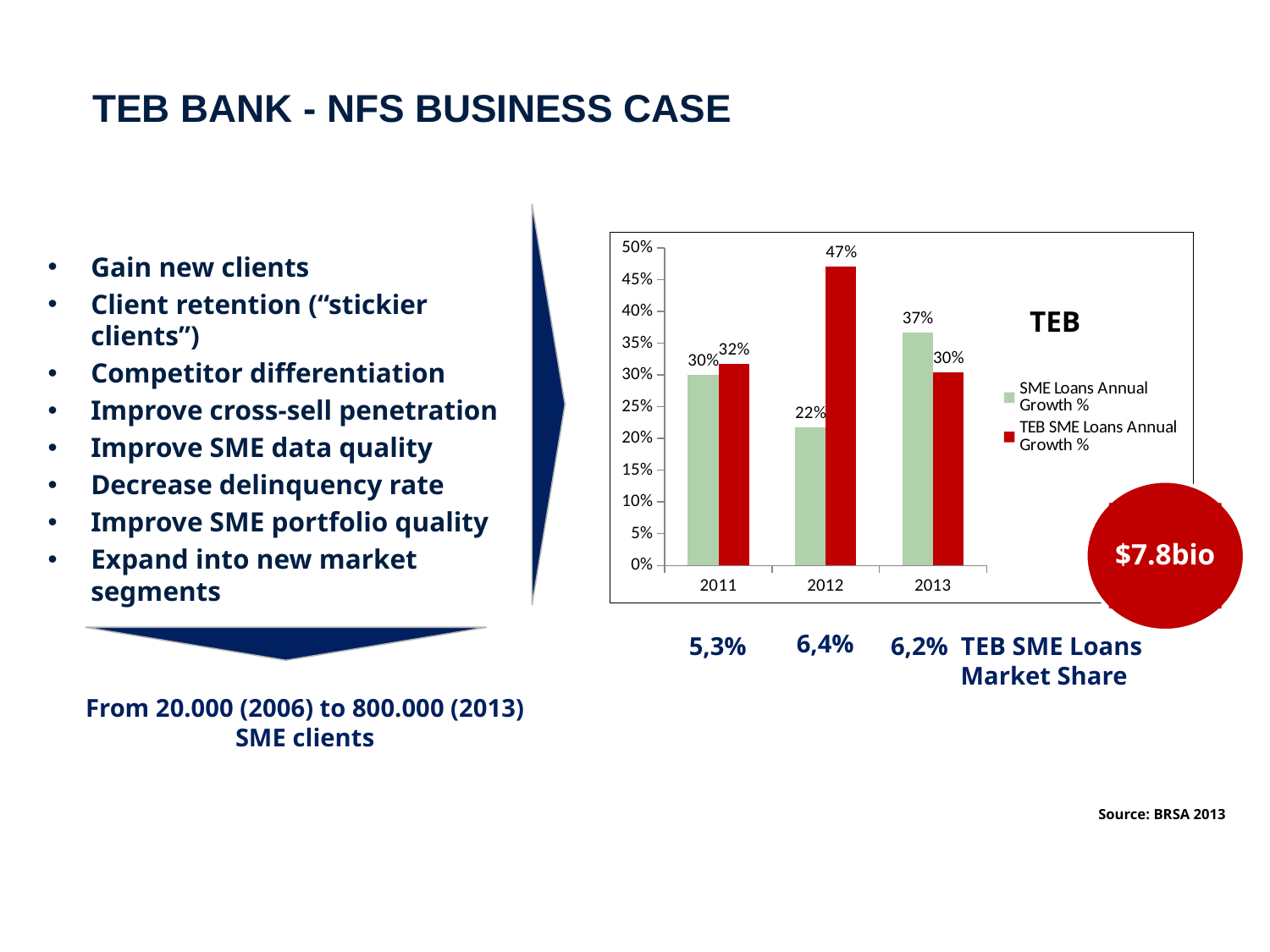
What is the SME Loans Annual Growth % for 2011? 30% In 2013, which is larger: the SME Loans Annual Growth % or the TEB SME Loans Annual Growth %? SME Loans Annual Growth % How many series does the chart legend list? 2 How many years are shown on the x axis of the chart? 3 What is the TEB SME Loans Annual Growth % for 2013? 30% What is the TEB SME Loans Annual Growth % for 2012? 47% What kind of chart is shown on the slide? Bar chart What is the difference between the TEB SME Loans Annual Growth % and the SME Loans Annual Growth % in 2012? 25% In which year is the TEB SME Loans Annual Growth % highest? 2012 In which year is the SME Loans Annual Growth % lowest? 2012 What is the SME Loans Annual Growth % for 2013? 37% What colour are the bars for the TEB SME Loans Annual Growth % series? Red